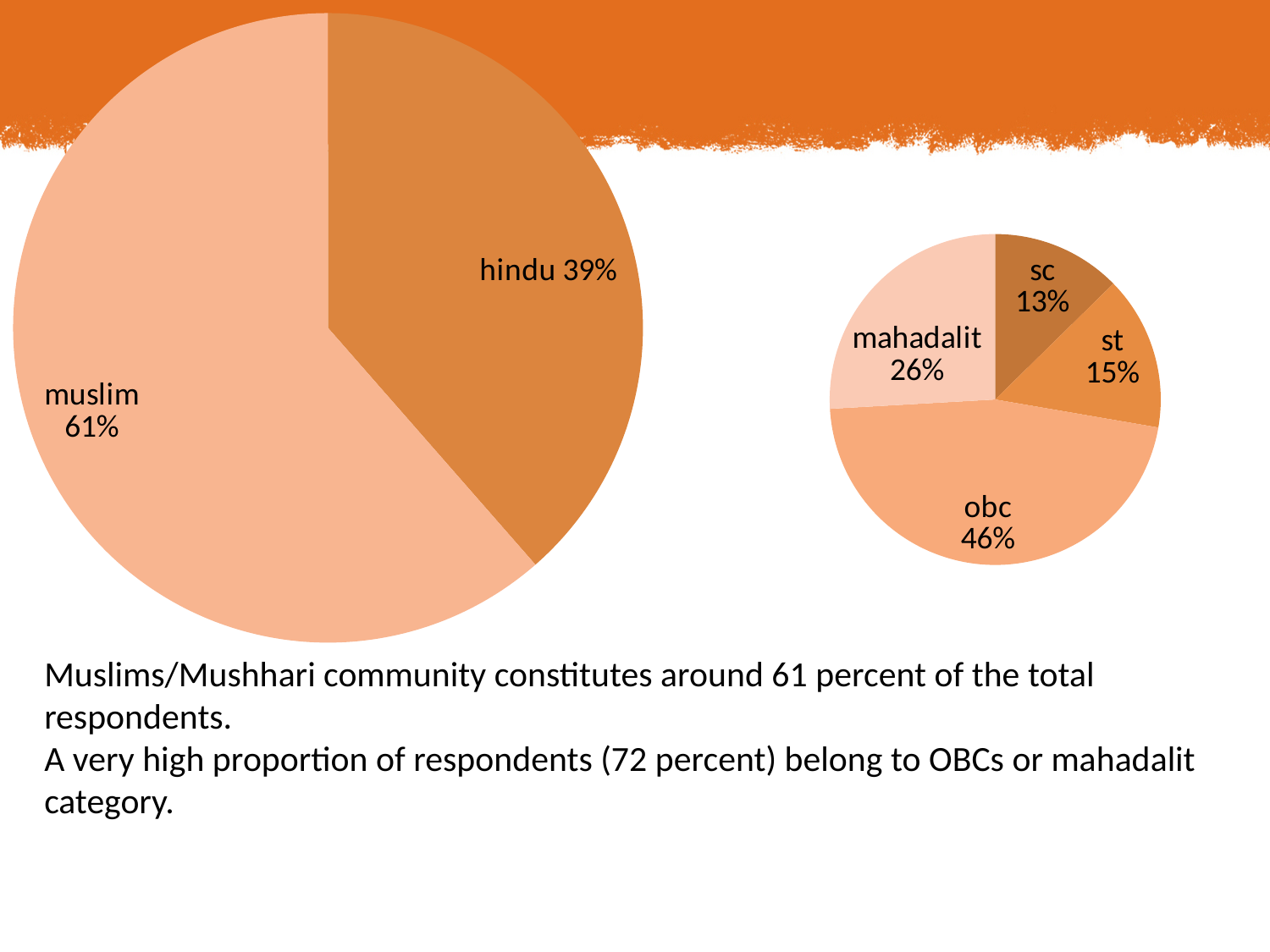
In the right pie chart, which category has the largest share? obc In the left pie chart, which slice is larger, muslim or hindu? muslim What type of chart is the left chart? pie chart In the left pie chart, what share of respondents is muslim? 61% In the right pie chart, what share is sc? 13% In the left pie chart, what share of respondents is hindu? 39% How many slices does the right pie chart have? 4 In the right pie chart, what share is mahadalit? 26% In the right pie chart, which category has the smallest share? sc In the right pie chart, what share is obc? 46% In the right pie chart, what is the difference in percentage points between obc and mahadalit? 20 In the left pie chart, what is the difference in percentage points between the muslim and hindu shares? 22